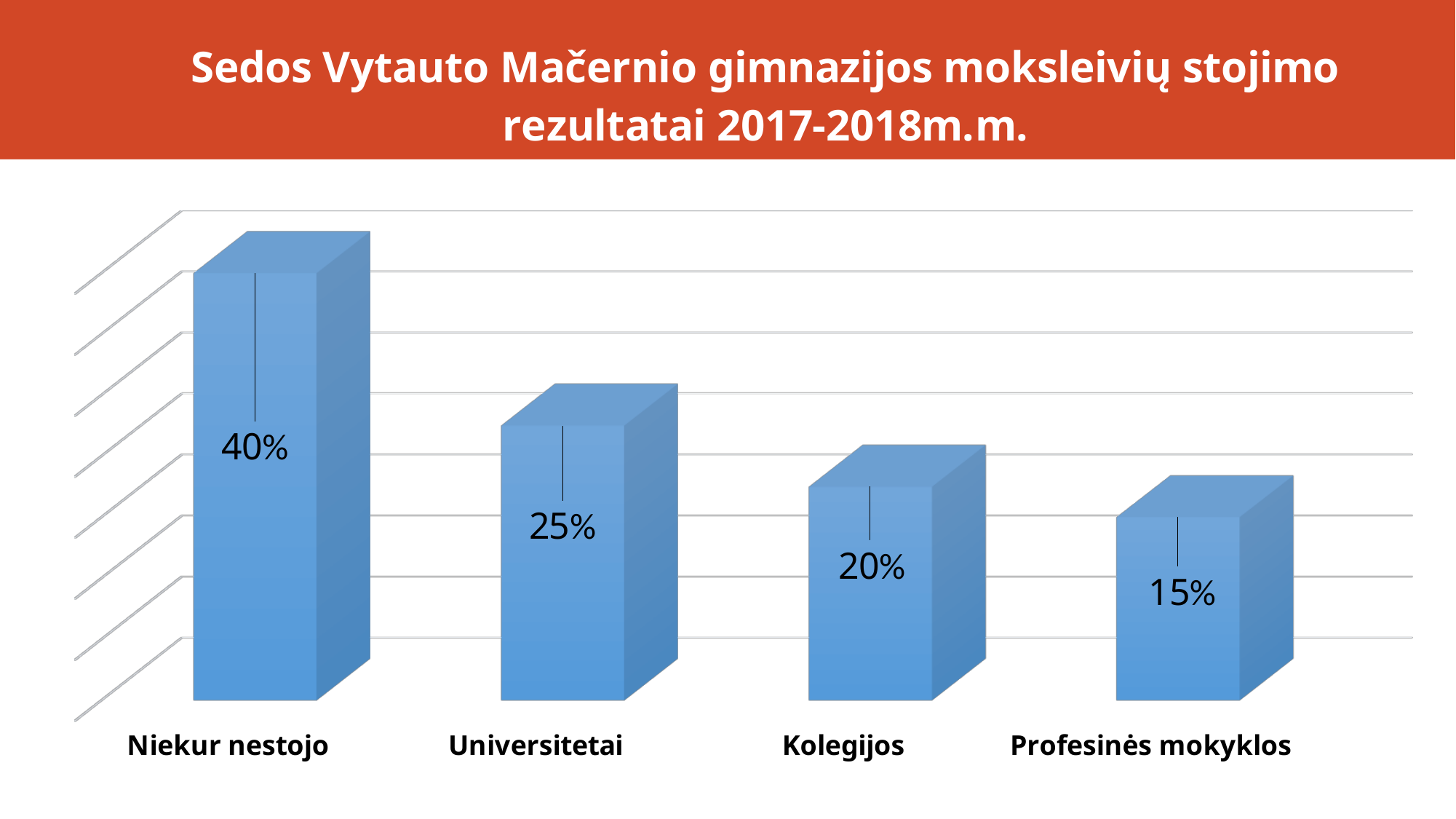
What is the value for Niekur nestojo? 40% What is the difference between the values for Kolegijos and Profesinės mokyklos? 5% What is the difference between the values for Niekur nestojo and Universitetai? 15% What is the value for Universitetai? 25% What is the value for Profesinės mokyklos? 15% What is the value for Kolegijos? 20% How many categories are shown in the chart? 4 Do the values rise or fall from left to right across the categories? Fall Which category has the highest value? Niekur nestojo Which is larger, the value for Universitetai or the value for Kolegijos? Universitetai What kind of chart is shown on the slide? Bar chart Which category has the lowest value? Profesinės mokyklos